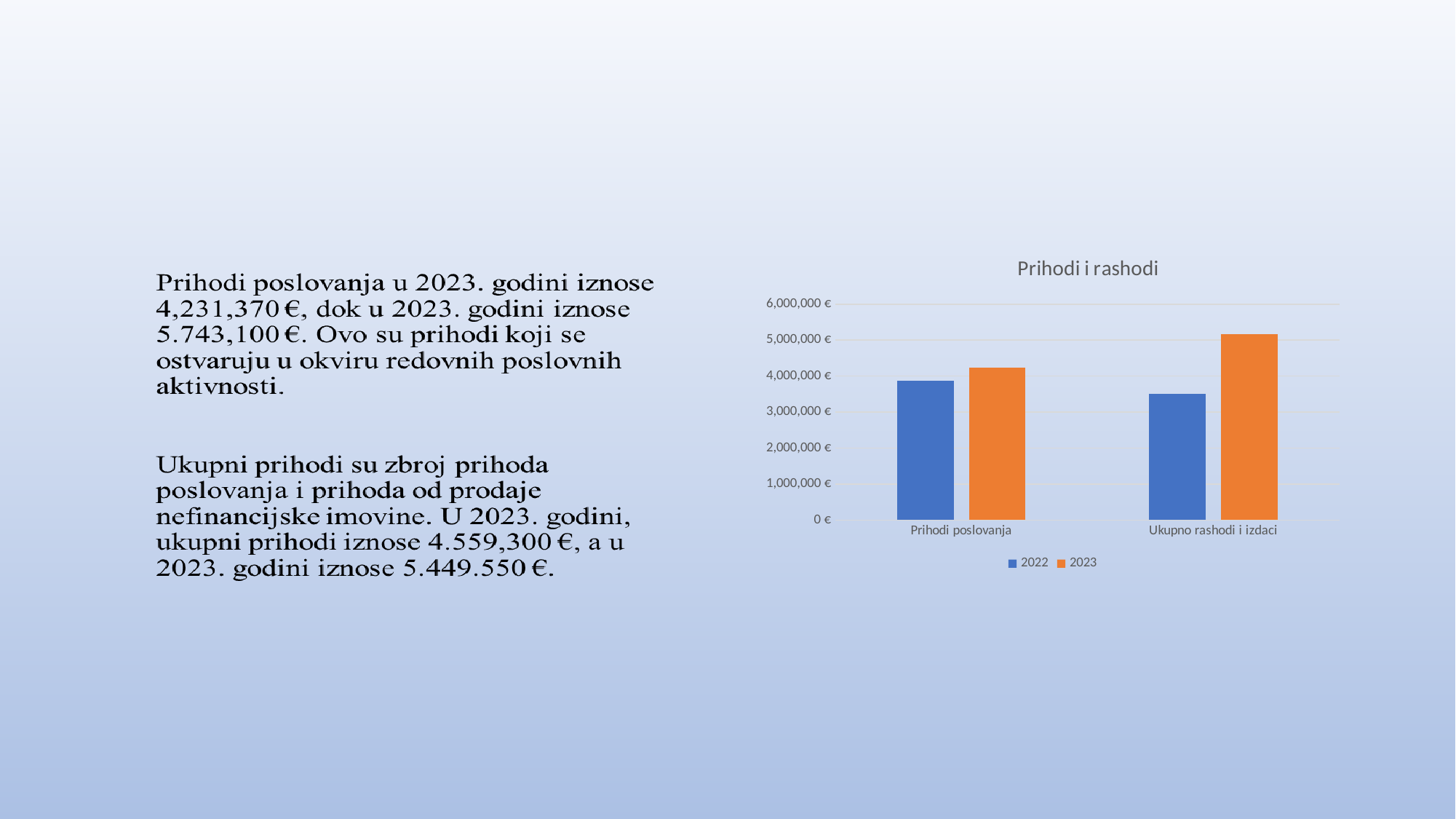
Which colour represents the 2023 series in the chart? orange How many series does the chart legend list? 2 Is the 2023 value for Ukupno rashodi i izdaci greater or less than 5,000,000 €? greater For Ukupno rashodi i izdaci, which year has the larger value, 2022 or 2023? 2023 Is the 2022 value for Ukupno rashodi i izdaci greater or less than 4,000,000 €? less What is the title of the chart? Prihodi i rashodi Which bar is the tallest in the chart? 2023 for Ukupno rashodi i izdaci What type of chart is shown on the slide? bar chart How many categories are shown on the x axis of the chart? 2 In the 2022 series, which category is larger, Prihodi poslovanja or Ukupno rashodi i izdaci? Prihodi poslovanja For Prihodi poslovanja, which year has the larger value, 2022 or 2023? 2023 Which bar is the shortest in the chart? 2022 for Ukupno rashodi i izdaci